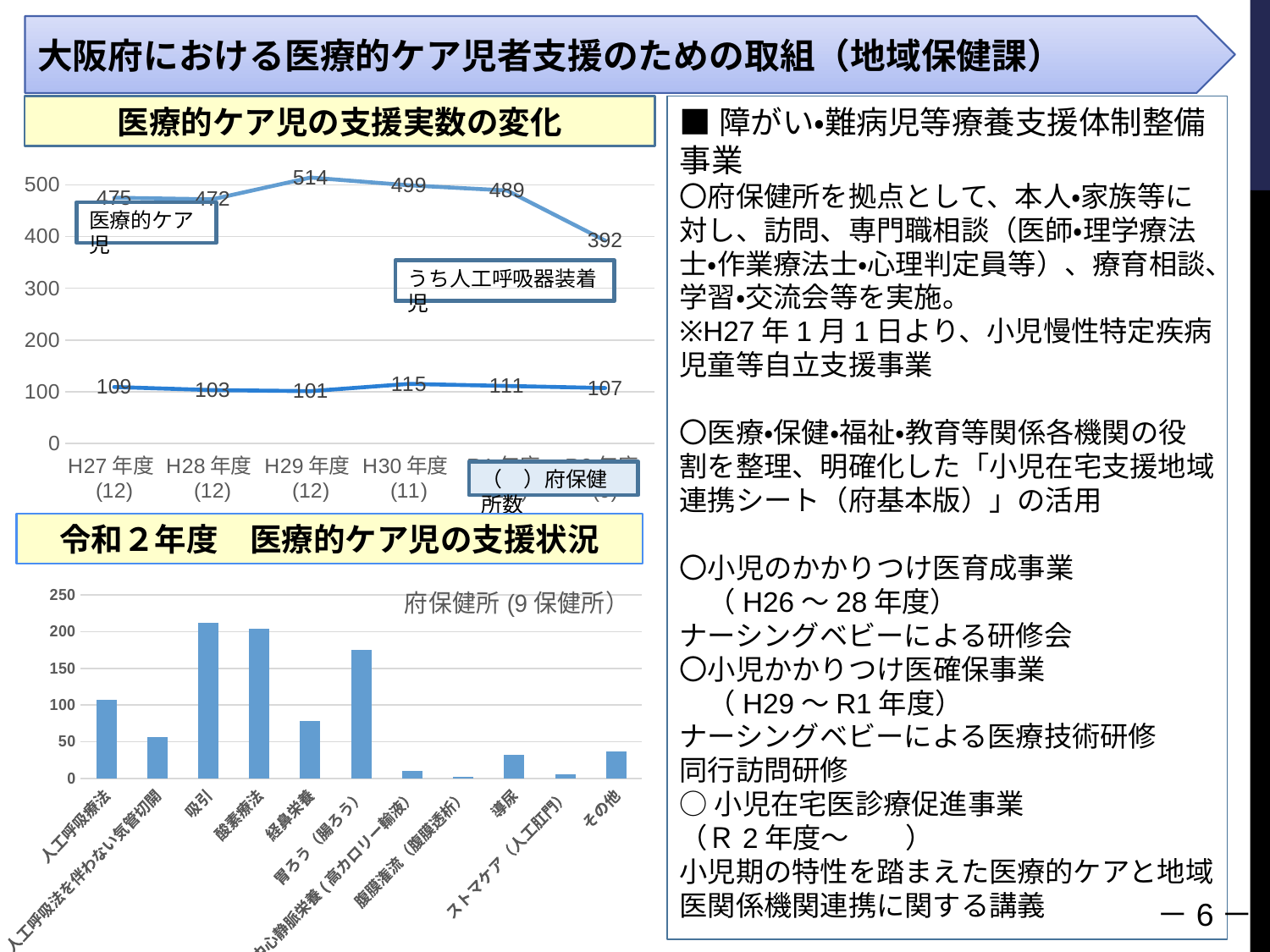
In the top chart 医療的ケア児の支援実数の変化, what is the lowest value shown for 医療的ケア児? 392 In the top chart 医療的ケア児の支援実数の変化, what is the value for 医療的ケア児 in H29年度? 514 How many categories are shown in the bottom chart 令和２年度 医療的ケア児の支援状況? 11 In the top chart 医療的ケア児の支援実数の変化, what is the difference between the 医療的ケア児 values for H29年度 and H30年度? 15 In the top chart 医療的ケア児の支援実数の変化, what is the value for うち人工呼吸器装着児 in H30年度? 115 What kind of chart is the bottom chart titled 令和２年度 医療的ケア児の支援状況? bar chart In the bottom chart 令和２年度 医療的ケア児の支援状況, is the value for 吸引 greater or less than 200? greater How many series are plotted in the top chart 医療的ケア児の支援実数の変化? 2 In the top chart 医療的ケア児の支援実数の変化, what is the difference between the うち人工呼吸器装着児 values for H27年度 and H28年度? 6 What kind of chart is the top chart titled 医療的ケア児の支援実数の変化? line chart In the bottom chart 令和２年度 医療的ケア児の支援状況, which is larger, the value for 酸素療法 or the value for 導尿? 酸素療法 In the top chart 医療的ケア児の支援実数の変化, in which year is the 医療的ケア児 value highest? H29年度